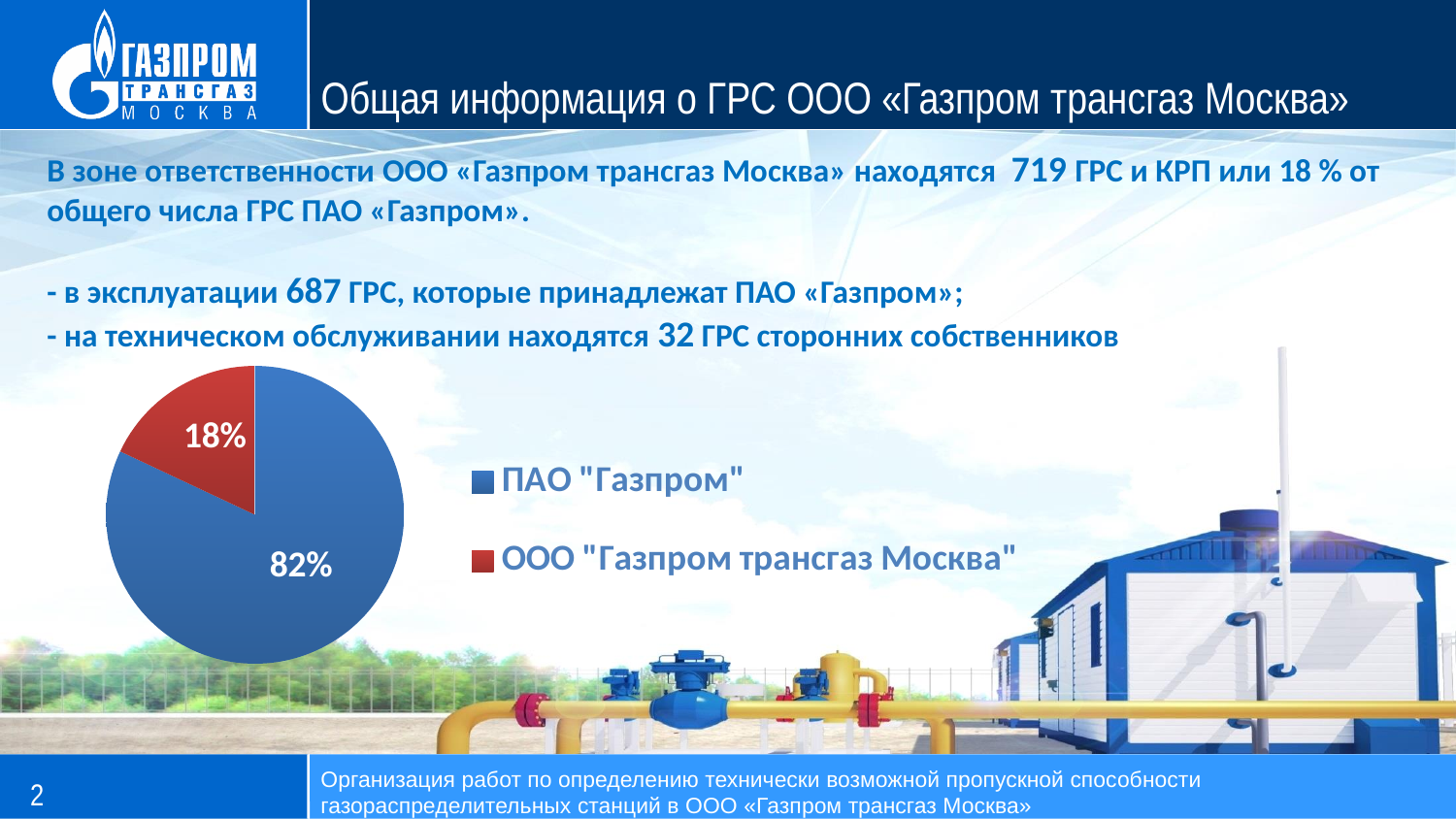
How many slices does the pie chart have? 2 Which slice of the pie chart is the smallest? ООО "Газпром трансгаз Москва" What share of the pie does ПАО "Газпром" hold? 82% What share of the pie does ООО "Газпром трансгаз Москва" hold? 18% Which is larger: the share for ПАО "Газпром" or the share for ООО "Газпром трансгаз Москва"? ПАО "Газпром" What kind of chart is shown on the slide? pie chart What is the total of the two percentages shown on the pie chart? 100% What colour is the slice for ПАО "Газпром" in the pie chart? blue How many entries does the legend of the pie chart list? 2 Which slice of the pie chart is the largest? ПАО "Газпром" What colour is the slice for ООО "Газпром трансгаз Москва" in the pie chart? red What is the difference in percentage points between the ПАО "Газпром" slice and the ООО "Газпром трансгаз Москва" slice? 64